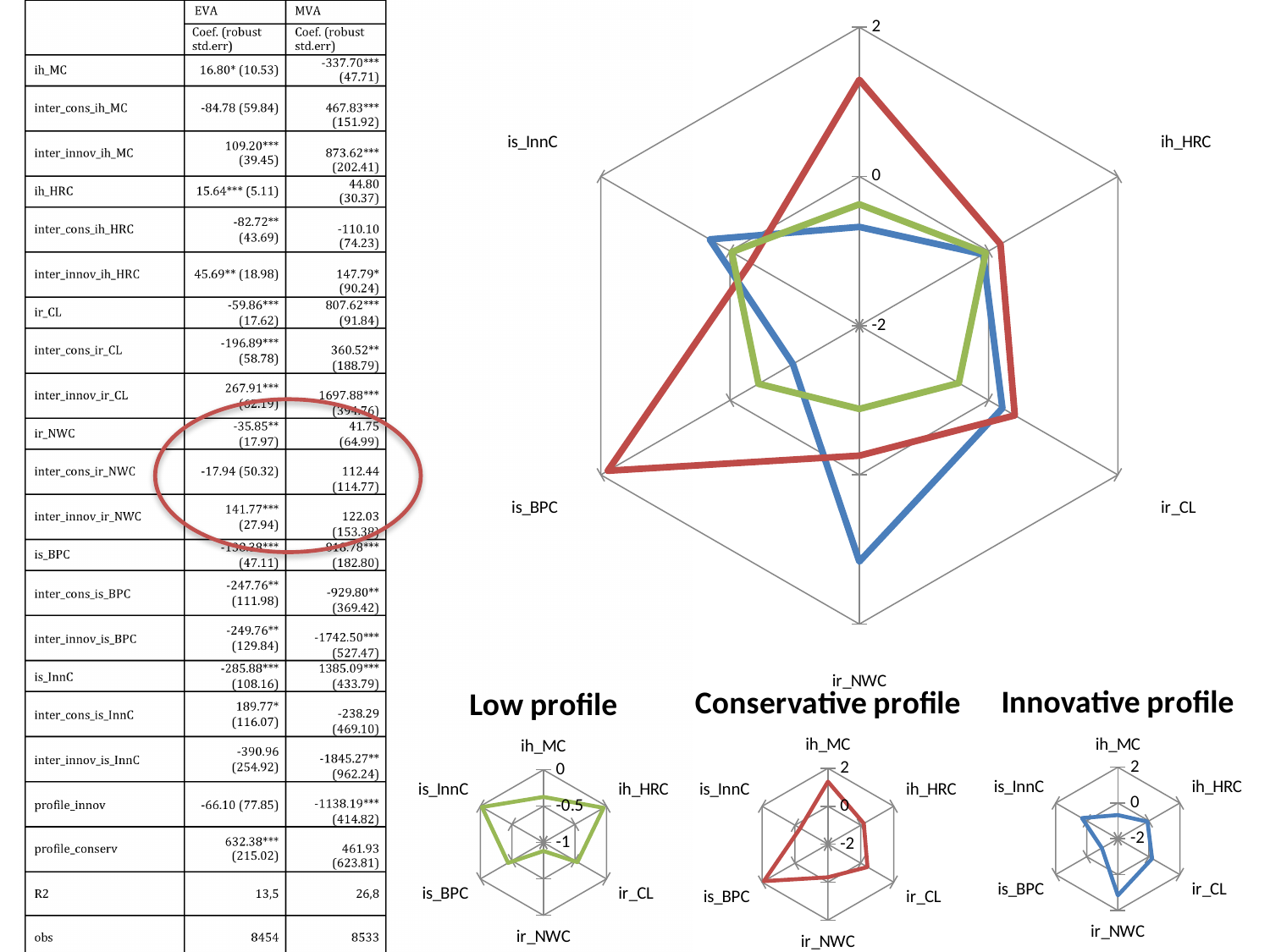
How many axes (categories) does the large radar chart have? 6 What kind of chart is the large chart on the right side of the slide? radar chart On the large radar chart, which series has the highest value for is_BPC? red On the large radar chart, is the value of the red series for is_BPC greater or less than 0? greater How many data series are plotted on the large radar chart? 3 What is the title of the small radar chart at the bottom left of the slide? Low profile On the large radar chart, which series has the highest value for ir_NWC? blue On the large radar chart, is the value of the red series for ih_MC greater or less than 0? greater How many small radar charts are shown along the bottom of the slide? 3 On the large radar chart, is the value of the green series for ir_NWC greater or less than 0? less What is the outermost axis tick value shown on the large radar chart? 2